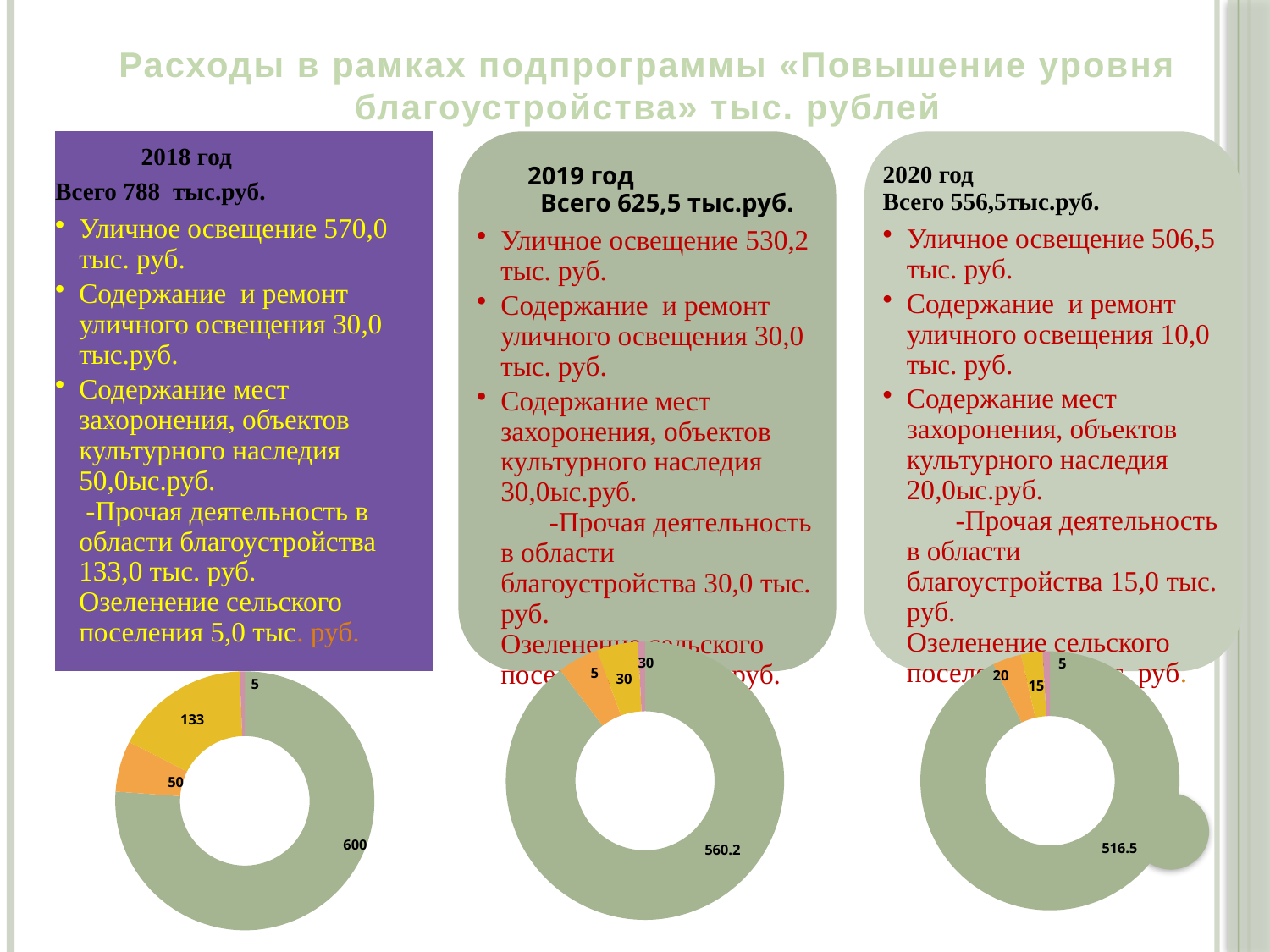
In the left chart (2018), what is the value of the smallest slice? 5 In the left chart (2018), which is larger: the slice labelled 133 or the slice labelled 50? 133 In the left chart (2018), what is the value of the largest slice? 600 How many slices does the left chart (2018) have? 4 In the middle chart (2019), what is the value of the largest slice? 560.2 In the middle chart (2019), what is the value of the smallest slice? 5 What kind of chart is the left chart under the 2018 column? doughnut chart How many slices does the right chart (2020) have? 4 In the left chart (2018), what is the difference between the slice labelled 600 and the slice labelled 133? 467 In the right chart (2020), what is the value of the largest slice? 516.5 In the right chart (2020), what is the difference between the slice labelled 20 and the slice labelled 15? 5 Which chart has the largest single slice value: the left (2018), middle (2019) or right (2020) chart? left (2018)